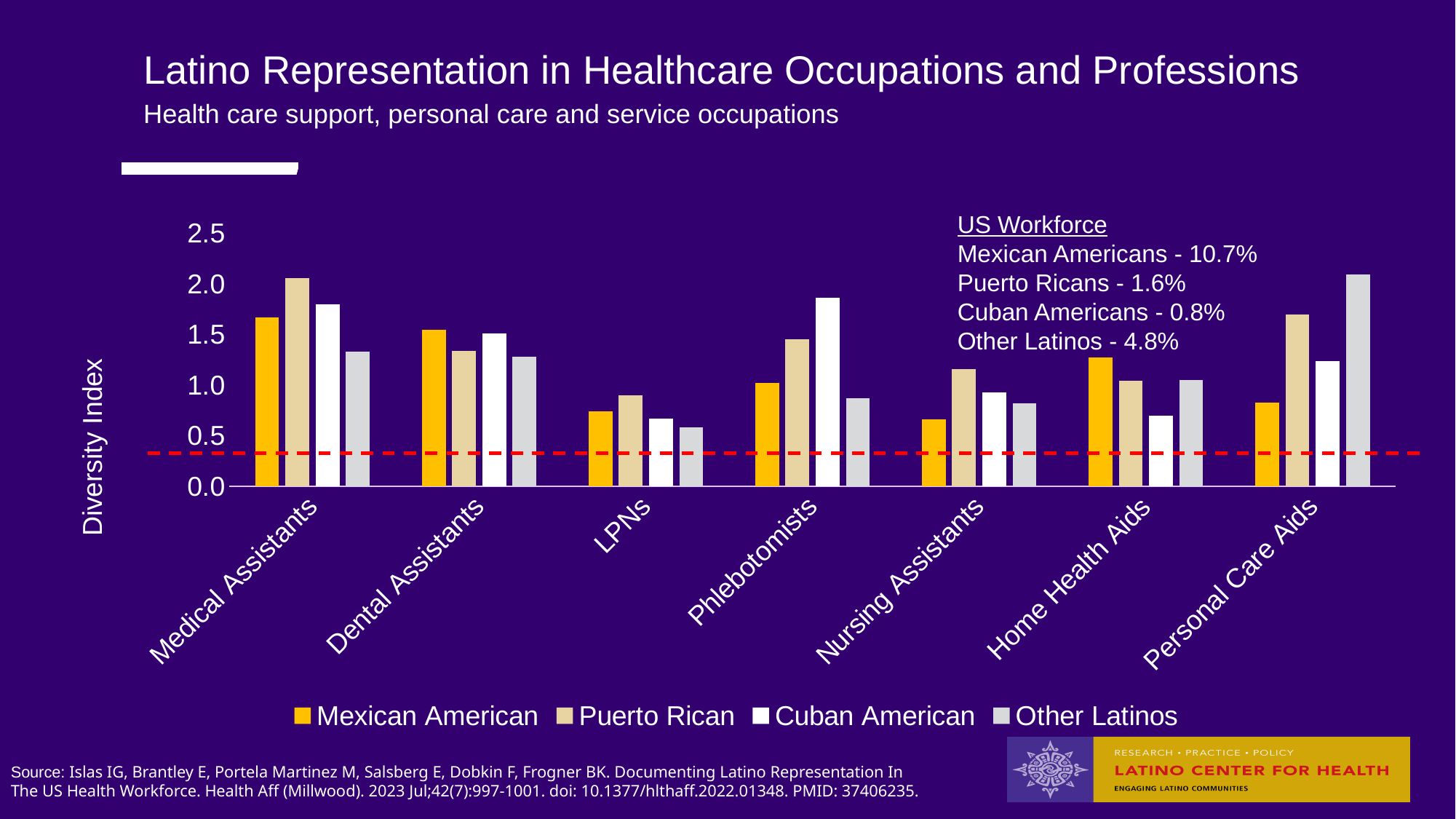
What kind of chart is shown on the slide? Bar chart What is the label on the y axis? Diversity Index Which group has the highest diversity index among Phlebotomists? Cuban American How many series does the legend list? 4 Is the Mexican American value for Medical Assistants greater or less than 1.5? greater Is the Cuban American value for Phlebotomists greater or less than 1.5? greater Which group has the lowest diversity index among LPNs? Other Latinos Which occupation has the highest Puerto Rican diversity index? Medical Assistants Is the Other Latinos value for LPNs greater or less than 1.0? less How many occupations are shown along the x axis? 7 For Home Health Aids, which is larger: the Mexican American value or the Cuban American value? Mexican American